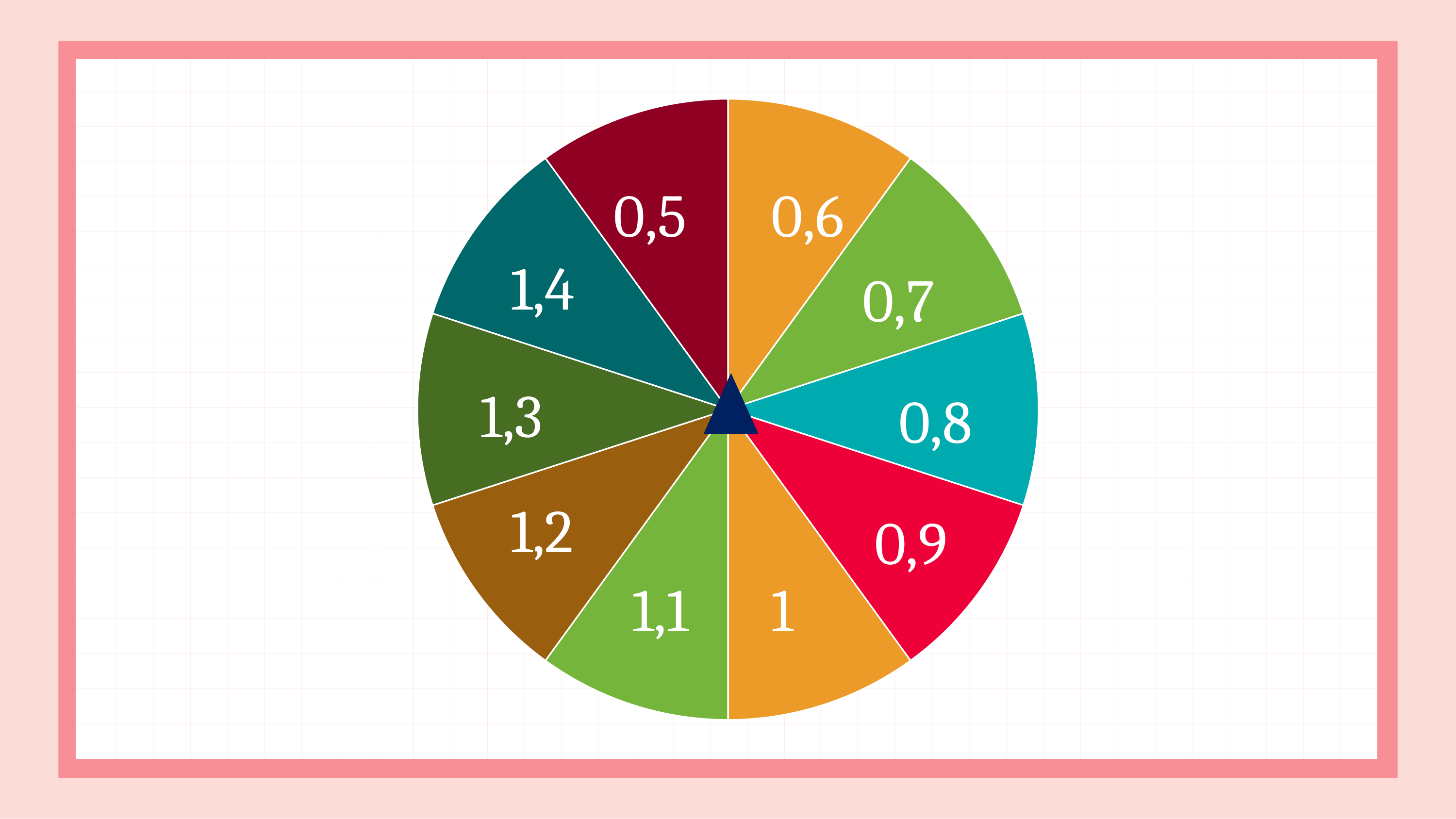
Are all the slices of the pie chart the same size? yes What is the smallest number printed on a slice of the pie chart? 0,5 What is the largest number printed on a slice of the pie chart? 1,4 How many slices does the pie chart have? 10 What kind of chart is shown on the slide? pie chart What label is printed on the dark red slice at the top left of the pie chart? 0,5